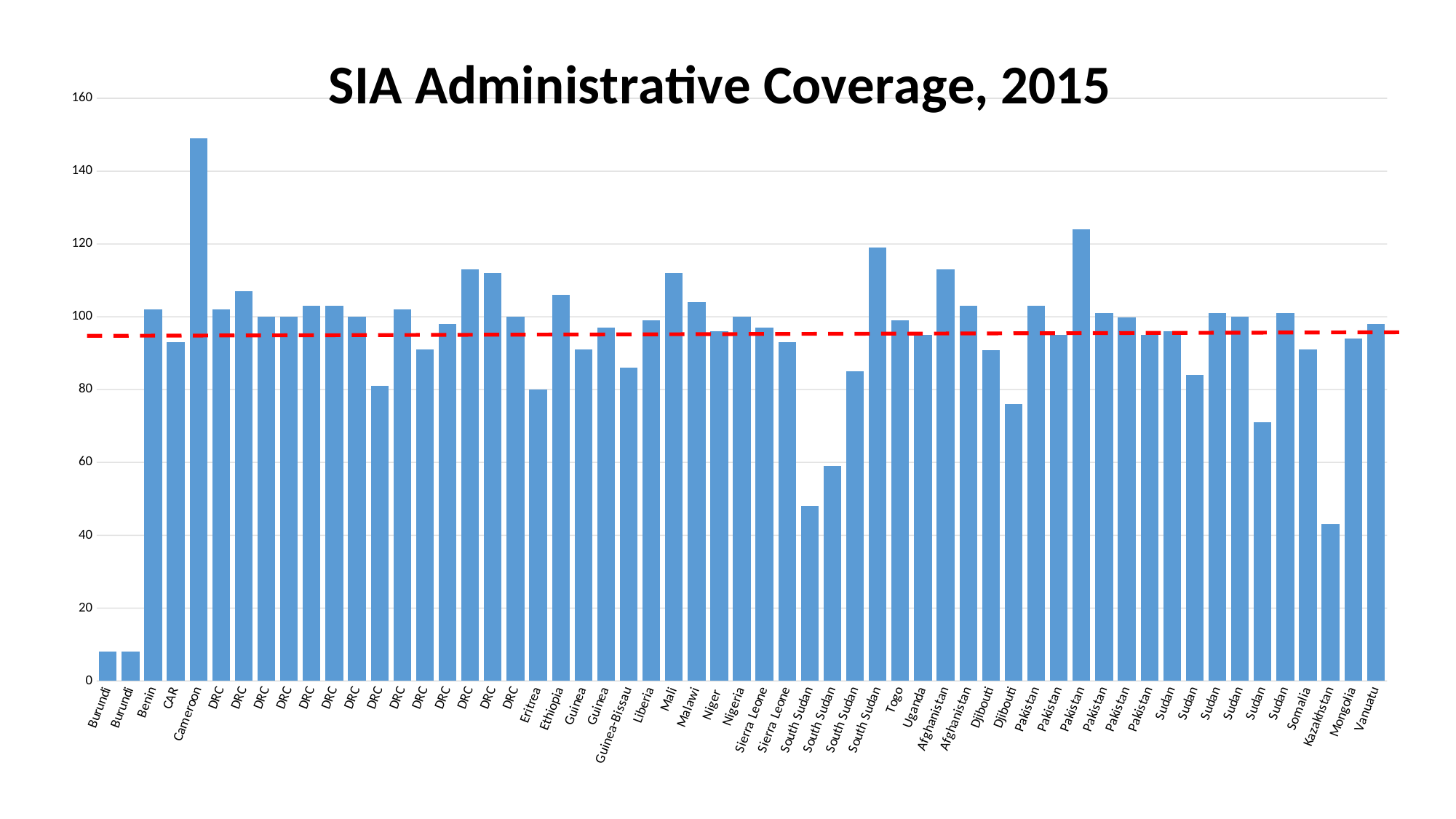
Is the value for Mali greater or less than 100? greater Which is larger, the value for Kazakhstan or the value for Somalia? Somalia What colour is the dashed horizontal line drawn across the chart? red What kind of chart is shown on the slide? bar chart Is the value for Kazakhstan greater or less than 60? less Is the value for Eritrea greater or less than 100? less Which is larger, the value for Cameroon or the value for Mali? Cameroon Which country has the lowest bars in the chart? Burundi Which category has the highest bar in the chart? Cameroon What is the title of the chart? SIA Administrative Coverage, 2015